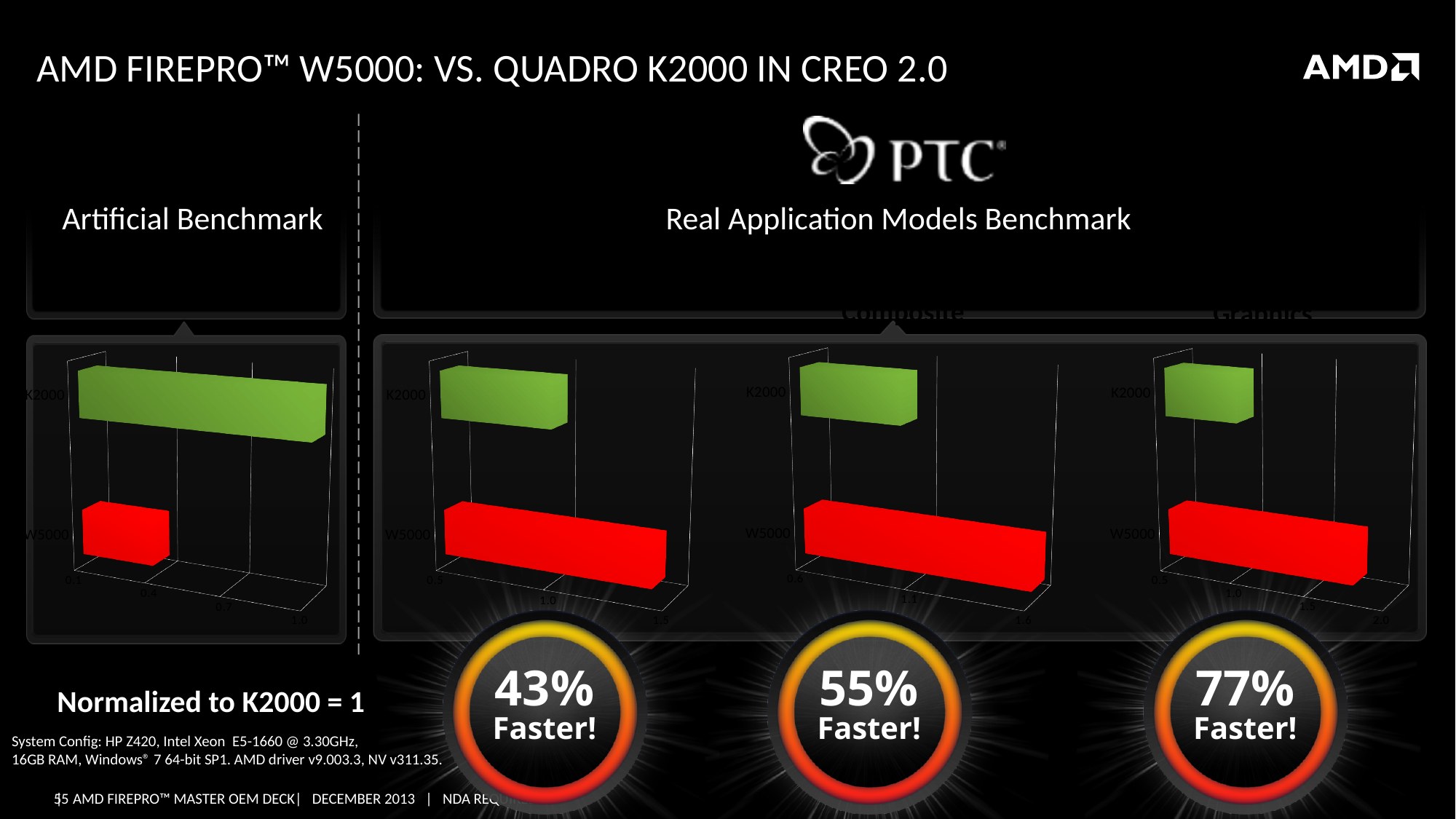
What colour are the W5000 bars in the charts? red According to the slide, the chart values are normalized so that K2000 equals what? 1 How many charts are shown on the slide? 4 In the rightmost chart under Real Application Models Benchmark, is the value for W5000 greater or less than 1.5? greater In the middle chart under Real Application Models Benchmark, is the value for W5000 greater or less than 1.1? greater In the Artificial Benchmark chart, how many categories are plotted? 2 In the leftmost chart under Real Application Models Benchmark, is the value for W5000 greater or less than 1.0? greater In the leftmost chart under Real Application Models Benchmark, which bar is longer, K2000 or W5000? W5000 In the Artificial Benchmark chart, which bar is longer, K2000 or W5000? K2000 What kind of chart is the Artificial Benchmark chart? bar chart